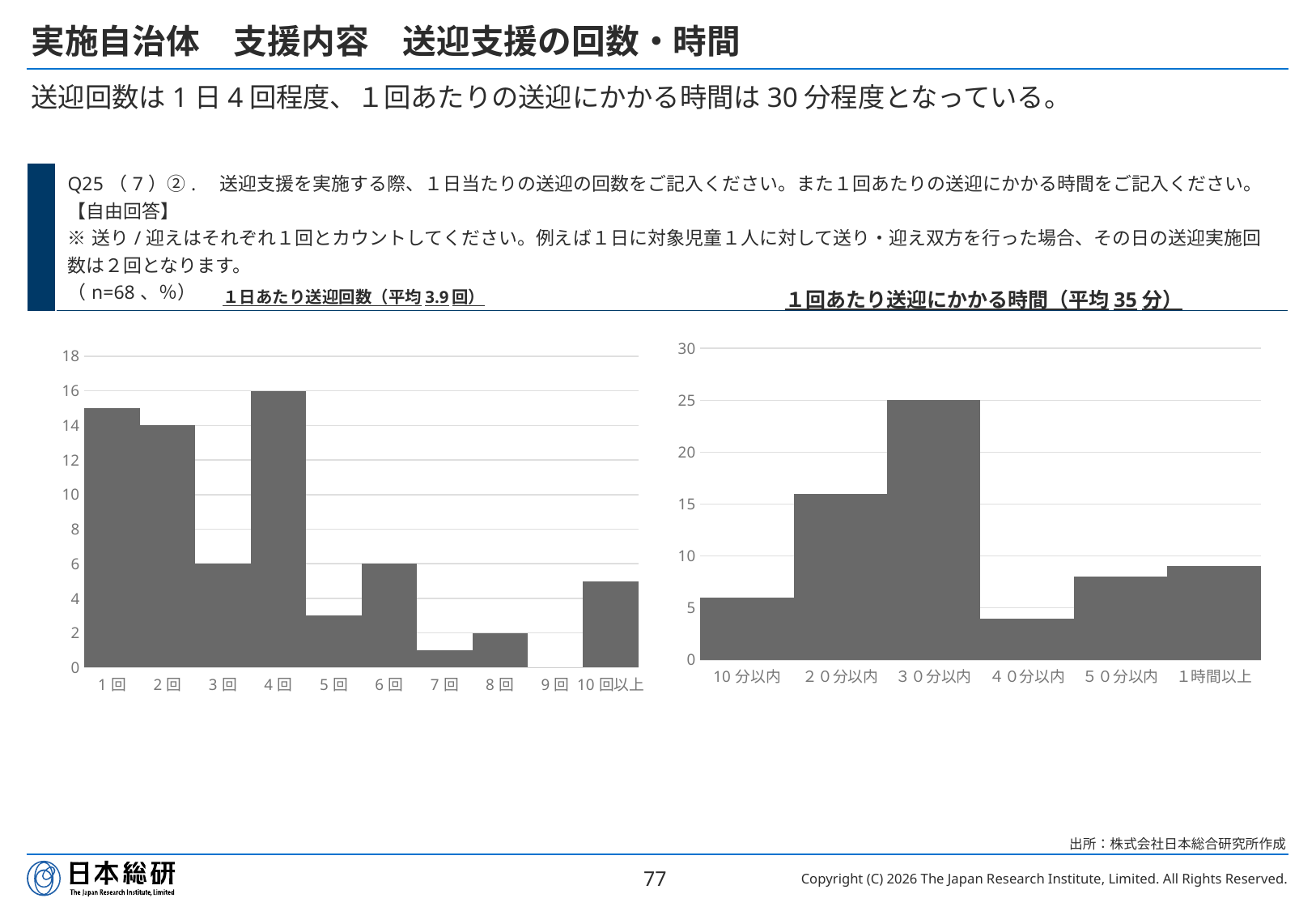
In the left chart (1日あたり送迎回数), what is the value for 8回? 2 In the left chart (1日あたり送迎回数), which is larger, the value for 2回 or the value for 3回? 2回 According to the title of the left chart, what is the average number of 送迎 per day? 3.9回 How many categories are shown on the x axis of the right chart (1回あたり送迎にかかる時間)? 6 In the left chart (1日あたり送迎回数), which category has the lowest value? 9回 In the left chart (1日あたり送迎回数), what is the difference between the values for 4回 and 2回? 2 In the right chart (1回あたり送迎にかかる時間), which category has the lowest value? 40分以内 In the right chart (1回あたり送迎にかかる時間), is the value for 20分以内 greater or less than 15? greater In the left chart (1日あたり送迎回数), what is the value for 4回? 16 In the right chart (1回あたり送迎にかかる時間), which category has the highest value? 30分以内 In the right chart (1回あたり送迎にかかる時間), what is the value for 30分以内? 25 In the left chart (1日あたり送迎回数), what is the value for 2回? 14